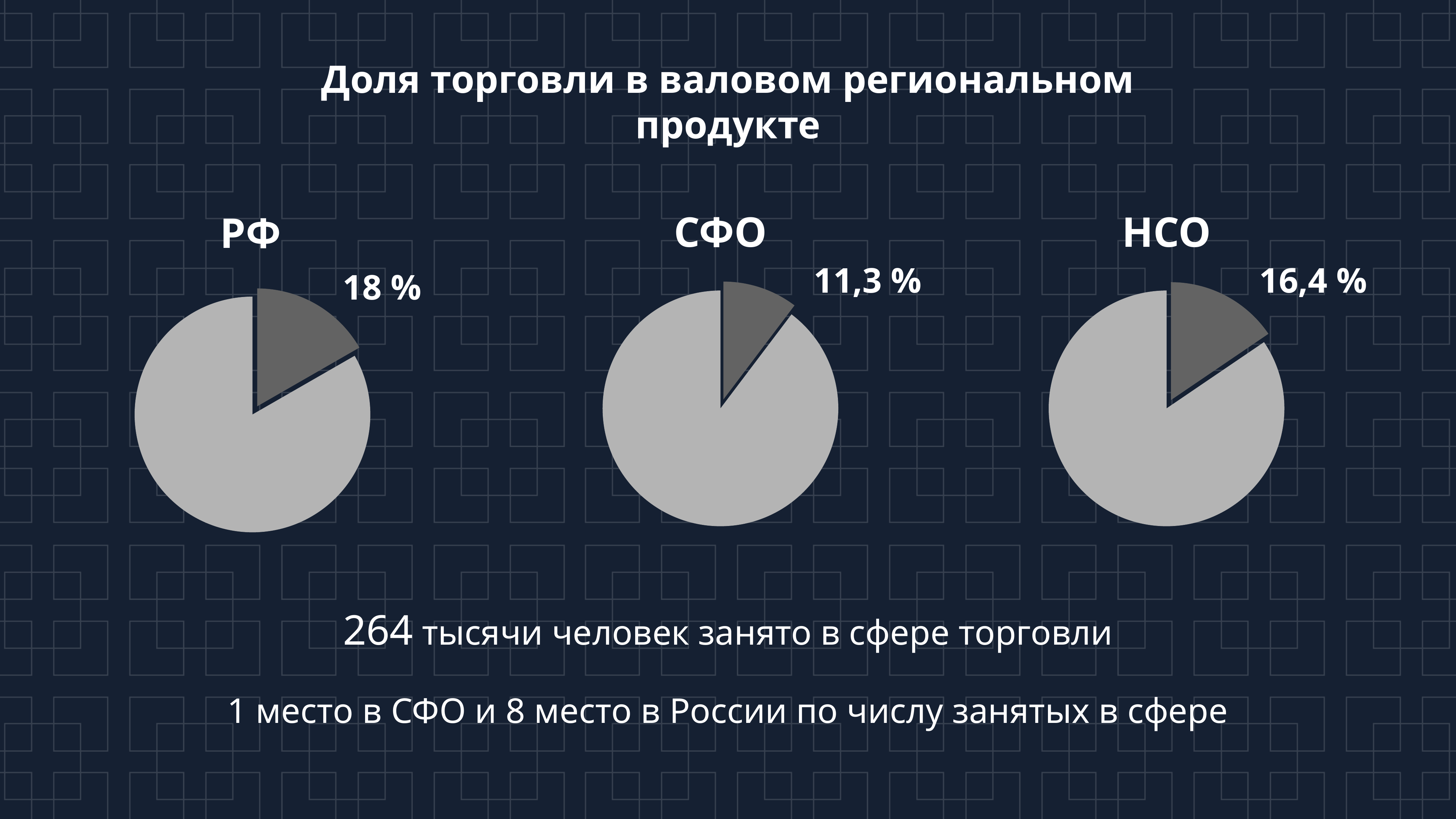
Is the share of trade in gross regional product larger for НСО or for СФО? НСО What is the share of trade in gross regional product shown for СФО? 11,3 % What is the difference between the share of trade for РФ and for СФО? 6,7 % Which of the three regions (РФ, СФО, НСО) has the highest share of trade in gross regional product? РФ What is the share of trade in gross regional product shown for РФ? 18 % Which of the three regions (РФ, СФО, НСО) has the lowest share of trade in gross regional product? СФО How many pie charts are shown on the slide? 3 What type of chart is used to show the share of trade for each region? Pie chart What is the title of the charts on the slide? Доля торговли в валовом региональном продукте What is the difference between the share of trade for НСО and for СФО? 5,1 % What is the share of trade in gross regional product shown for НСО? 16,4 % Is the share of trade in gross regional product larger for РФ or for НСО? РФ